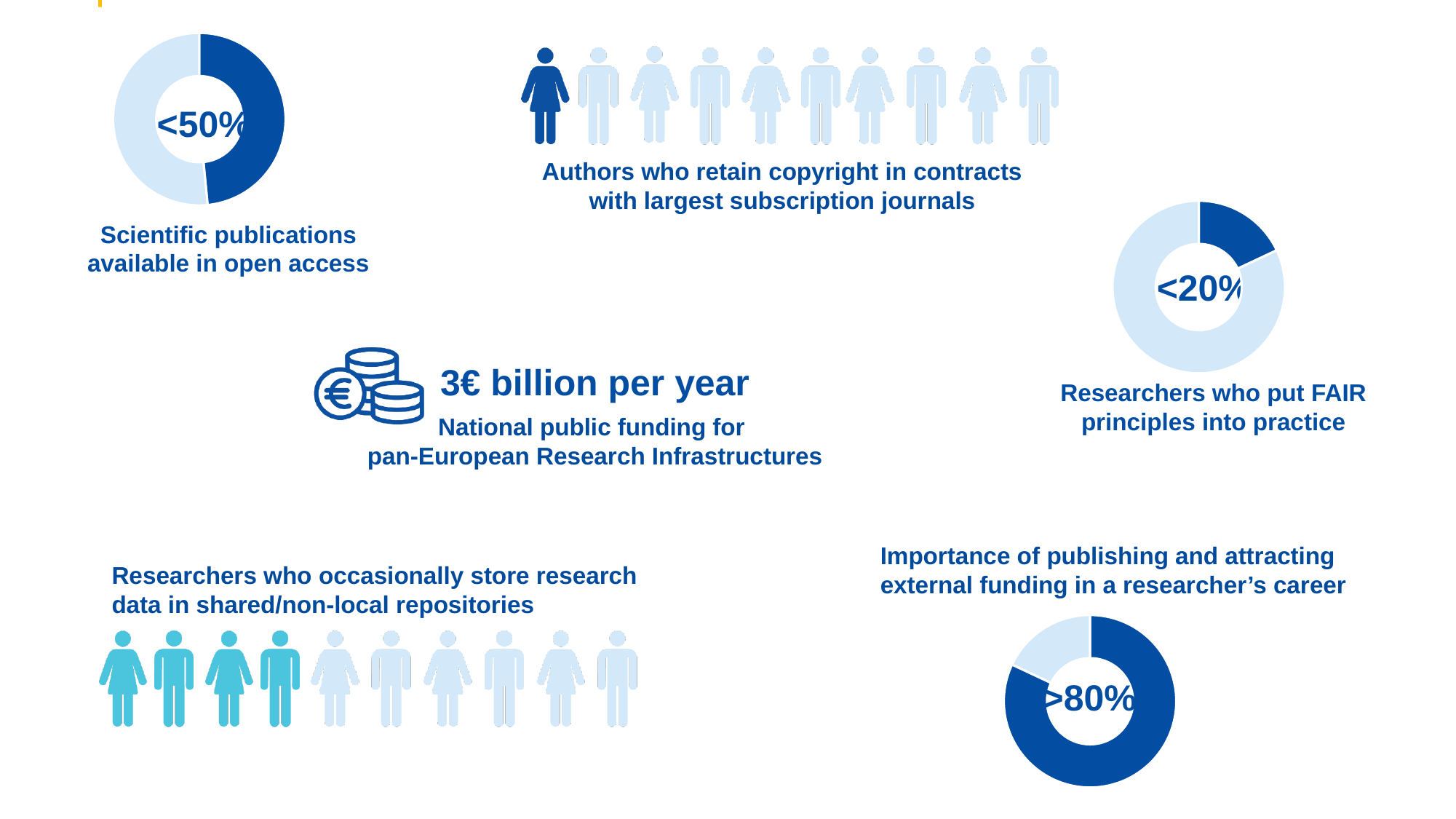
Which donut chart shows the largest highlighted share: 'Scientific publications available in open access', 'Researchers who put FAIR principles into practice', or 'Importance of publishing and attracting external funding in a researcher's career'? Importance of publishing and attracting external funding in a researcher's career What kind of chart is used to show 'Scientific publications available in open access'? Donut chart How many donut charts are shown on the slide? 3 In the pictograph 'Authors who retain copyright in contracts with largest subscription journals', how many person icons are shown in total? 10 Which donut chart shows the smallest highlighted share: 'Scientific publications available in open access', 'Researchers who put FAIR principles into practice', or 'Importance of publishing and attracting external funding in a researcher's career'? Researchers who put FAIR principles into practice In the pictograph 'Researchers who occasionally store research data in shared/non-local repositories', how many person icons are highlighted in teal? 4 What value is printed in the centre of the donut chart labelled 'Researchers who put FAIR principles into practice'? <20% What value is printed in the centre of the donut chart labelled 'Importance of publishing and attracting external funding in a researcher's career'? >80% In the pictograph 'Researchers who occasionally store research data in shared/non-local repositories', how many person icons are shown in total? 10 What value is printed in the centre of the donut chart labelled 'Scientific publications available in open access'? <50% In the pictograph 'Authors who retain copyright in contracts with largest subscription journals', how many person icons are highlighted in dark blue? 1 Which pictograph has more highlighted person icons: 'Authors who retain copyright in contracts with largest subscription journals' or 'Researchers who occasionally store research data in shared/non-local repositories'? Researchers who occasionally store research data in shared/non-local repositories